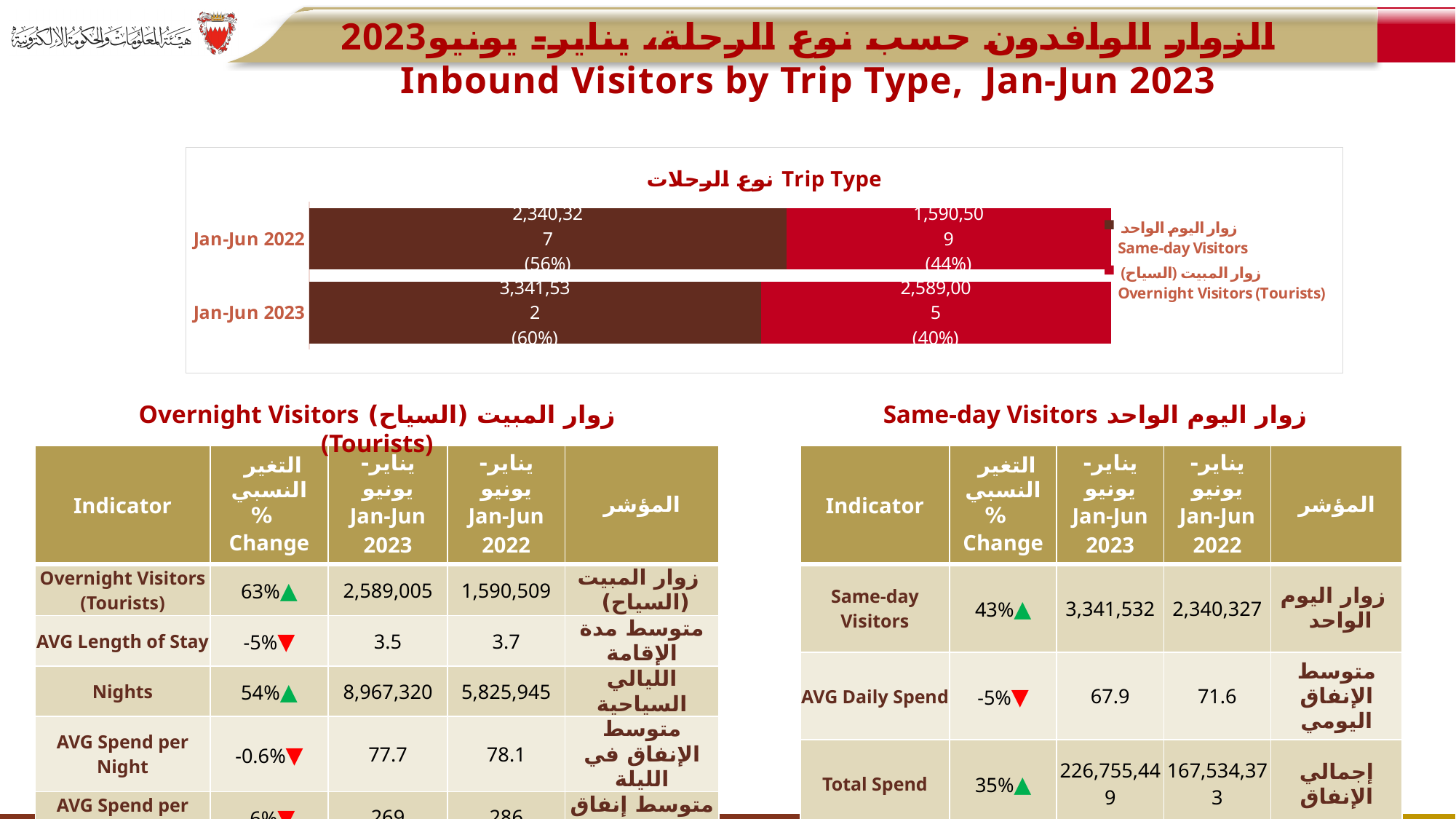
In the Trip Type chart, how many periods (categories) are plotted? 2 In the Trip Type chart, what is the difference between Same-day Visitors in Jan-Jun 2023 and Jan-Jun 2022? 1,001,205 In the Trip Type chart, what percentage share is shown for Same-day Visitors in Jan-Jun 2022? 56% In the Trip Type chart, what is the value for Same-day Visitors in Jan-Jun 2023? 3,341,532 In the Trip Type chart, what is the value for Overnight Visitors (Tourists) in Jan-Jun 2022? 1,590,509 In the Trip Type chart, which is larger in Jan-Jun 2023: Same-day Visitors or Overnight Visitors (Tourists)? Same-day Visitors In the Trip Type chart, what is the total of the Jan-Jun 2022 stacked bar? 3,930,836 In the Trip Type chart, what is the total of the Jan-Jun 2023 stacked bar? 5,930,537 What type of chart is shown under the title "Trip Type"? Bar chart In the Trip Type chart, which colour represents Overnight Visitors (Tourists)? Red In the Trip Type chart, what percentage share is shown for Overnight Visitors (Tourists) in Jan-Jun 2023? 40% In the Trip Type chart, how many series does the legend list? 2